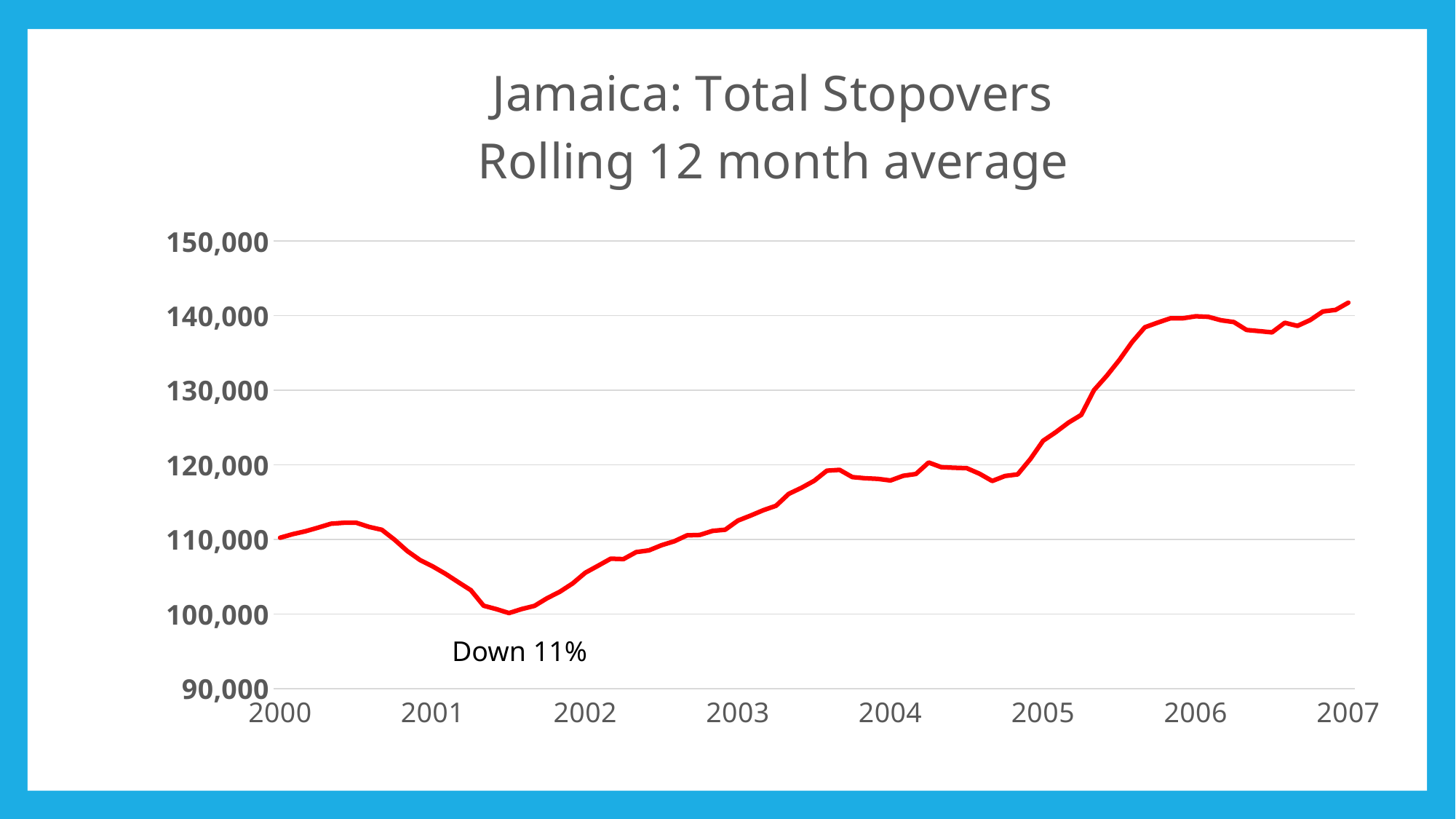
How many year labels are shown on the x axis? 8 Is the value at the start of 2000 greater or less than 120,000? less Does the line rise or fall between 2005 and 2006? rise What is the title of the chart? Jamaica: Total Stopovers Rolling 12 month average Is the value at the start of 2002 greater or less than 110,000? less Is the value at the start of 2006 greater or less than 130,000? greater What kind of chart is shown on the slide? line chart Does the line rise or fall between the start of 2000 and the start of 2001? fall What does the annotation near the low point of the line say? Down 11%